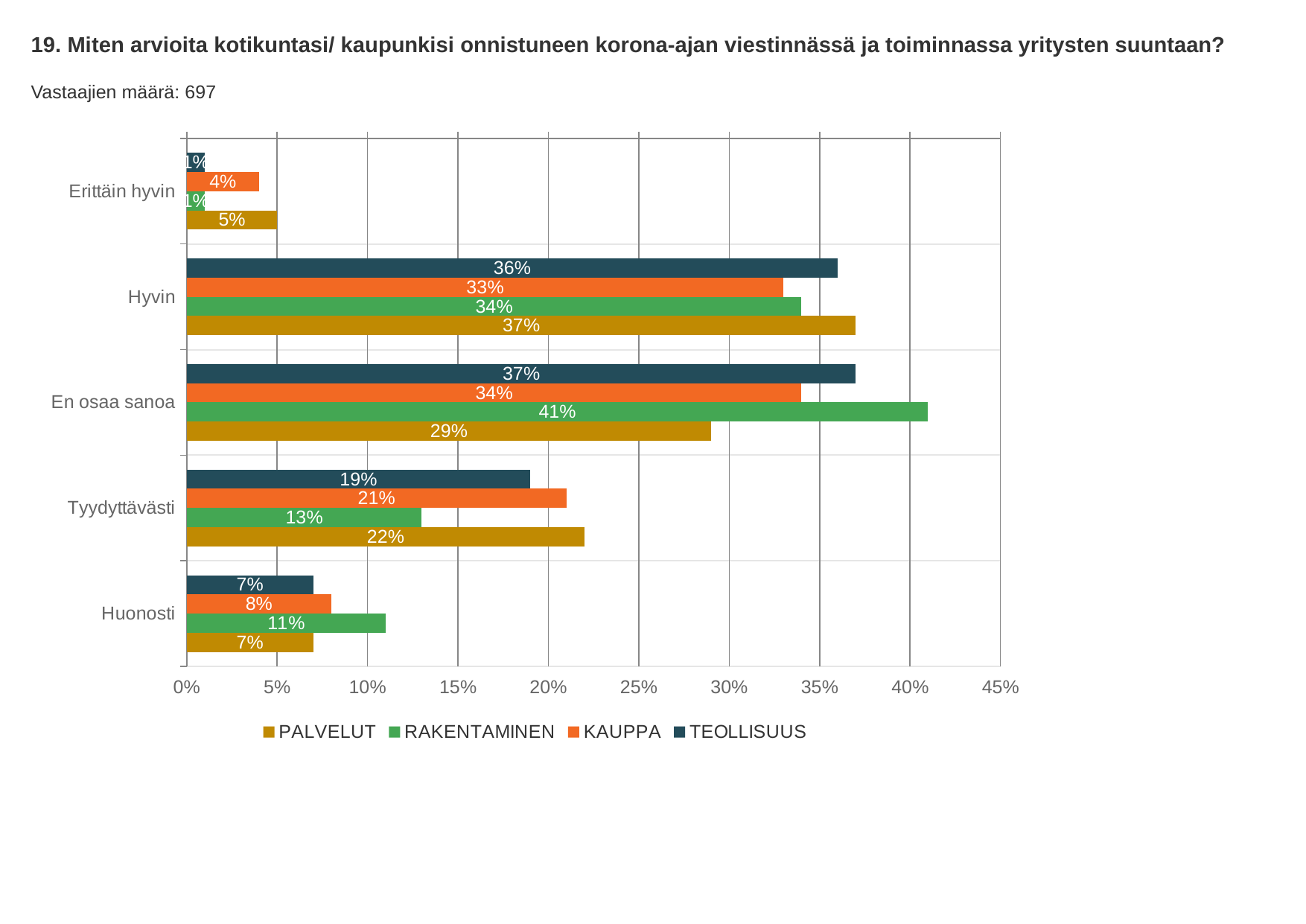
What is the value for KAUPPA in the Tyydyttävästi category? 21% In the Huonosti category, which is larger: the RAKENTAMINEN value or the KAUPPA value? RAKENTAMINEN How many response categories are shown on the chart? 5 What is the difference between the PALVELUT and RAKENTAMINEN values in the Tyydyttävästi category? 9% What is the value for RAKENTAMINEN in the En osaa sanoa category? 41% How many series does the legend list? 4 Which series has the lowest value in the Tyydyttävästi category? RAKENTAMINEN Is the value for PALVELUT in the En osaa sanoa category greater or less than 30%? less What is the value for TEOLLISUUS in the Huonosti category? 7% What kind of chart is shown on the slide? Bar chart Which series has the highest value in the En osaa sanoa category? RAKENTAMINEN What is the value for PALVELUT in the Hyvin category? 37%